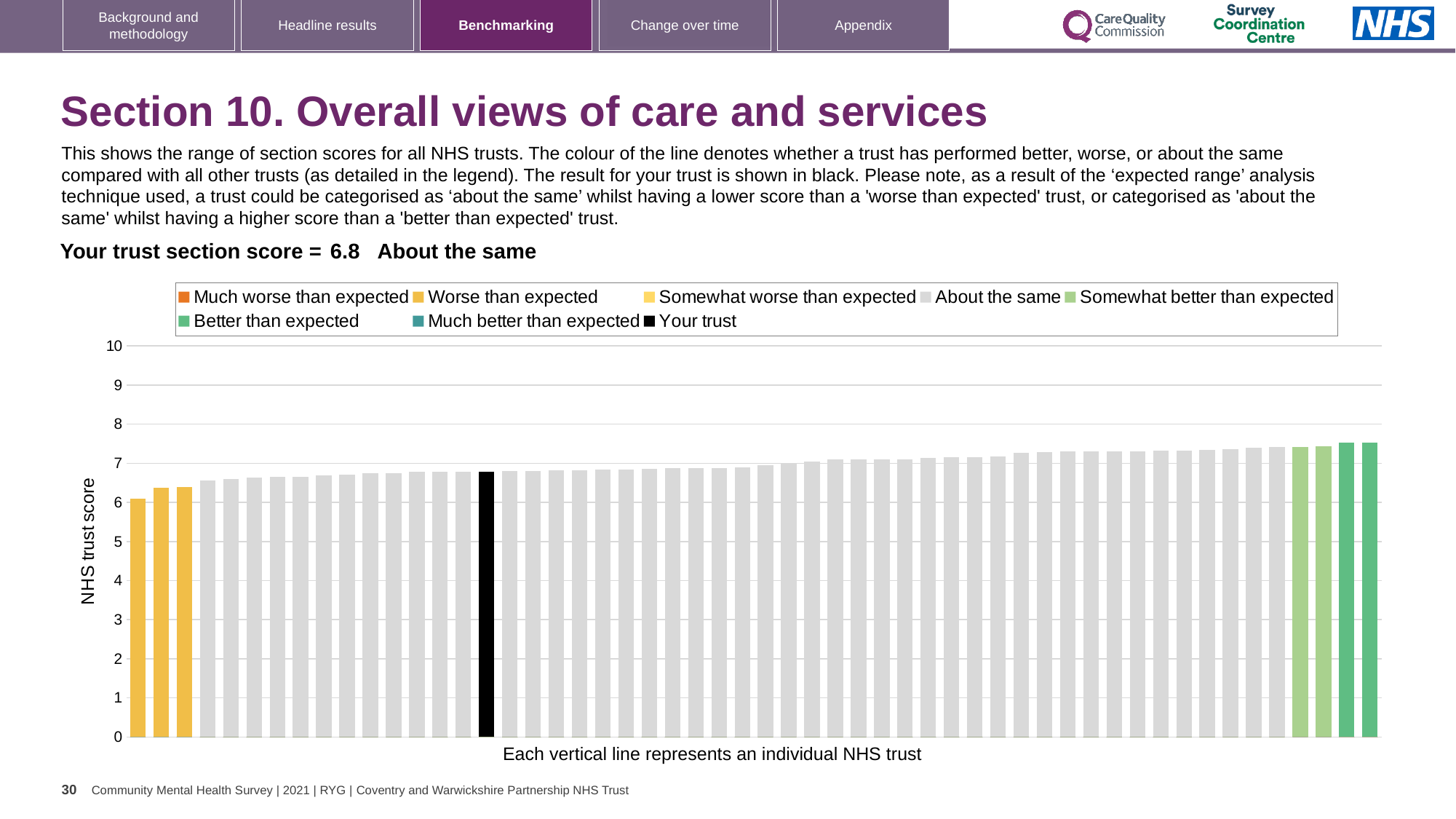
Is the value for the rightmost bar greater or less than 7? greater Is the value for the rightmost bar greater or less than 8? less Which legend category do the tallest bars belong to? Better than expected Which is larger, the leftmost bar or the rightmost bar? the rightmost bar Is the value for the leftmost bar greater or less than 7? less Which legend category do the shortest bars belong to? Worse than expected Do the bar values rise or fall from left to right along the x axis? rise What is the section score for your trust shown on the slide? 6.8 What kind of chart is shown on the slide? bar chart What is the label on the vertical axis of the chart? NHS trust score How many entries does the chart legend list? 8